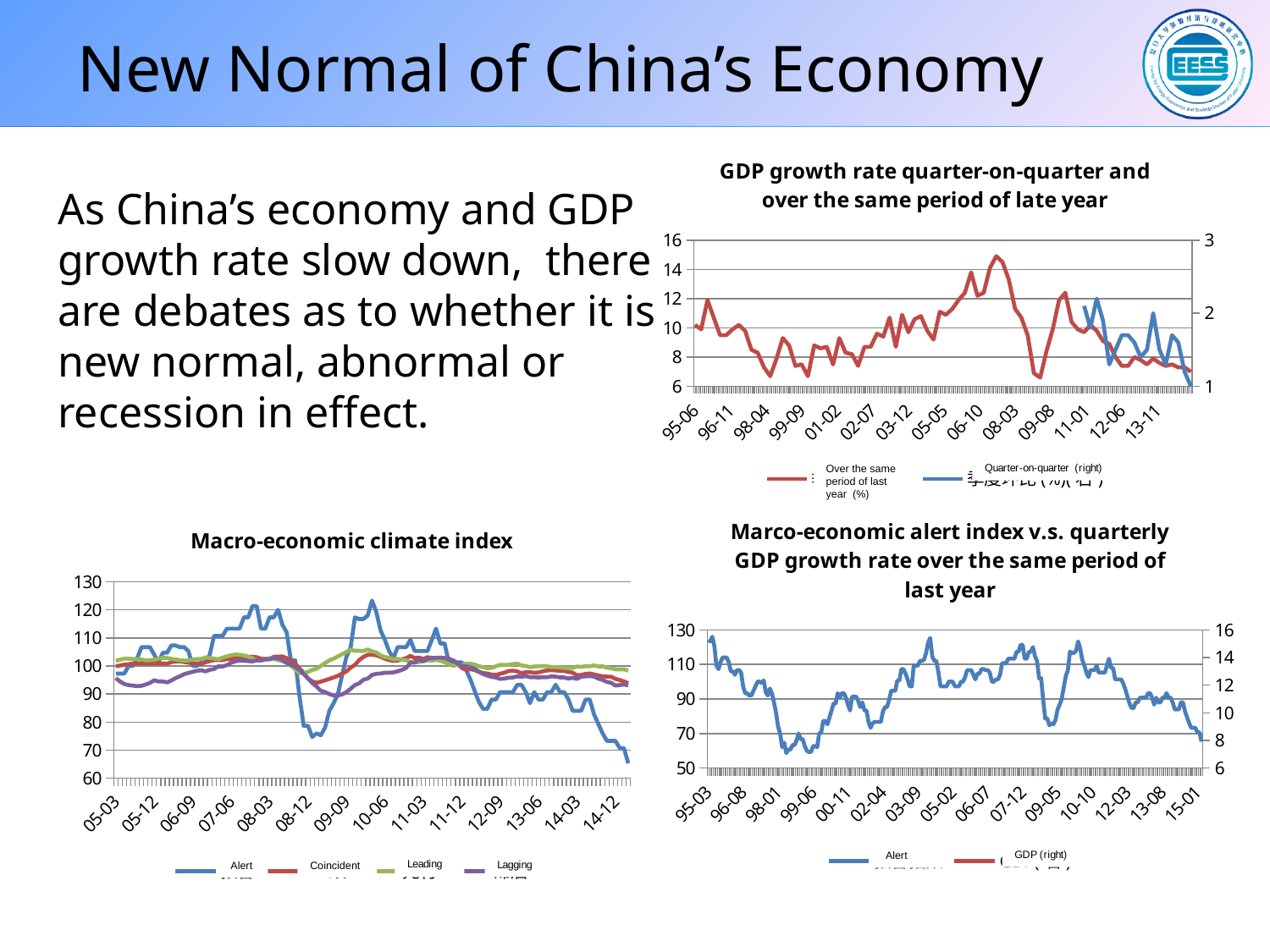
In the "Marco-economic alert index v.s. quarterly GDP growth rate over the same period of last year" chart, which series is plotted on the right axis? GDP What is the highest value shown on the left axis of the "Macro-economic climate index" chart? 130 In the "Macro-economic climate index" chart, is the Alert value at 14-12 greater or less than 70? greater How many series does the legend of the "Marco-economic alert index v.s. quarterly GDP growth rate over the same period of last year" chart list? 2 What kind of chart is the "Macro-economic climate index" chart? line chart In the "Marco-economic alert index v.s. quarterly GDP growth rate over the same period of last year" chart, is the Alert value at 95-03 higher or lower than at 15-01? higher How many series does the legend of the "Macro-economic climate index" chart list? 4 In the "GDP growth rate quarter-on-quarter and over the same period of late year" chart, does the Quarter-on-quarter line generally rise or fall from 11-01 to 13-11? fall In the "Marco-economic alert index v.s. quarterly GDP growth rate over the same period of last year" chart, does the Alert line rise or fall from 13-08 to 15-01? fall In the "GDP growth rate quarter-on-quarter and over the same period of late year" chart, is the lowest value of the "Over the same period of last year" line greater or less than 8? less How many series does the legend of the "GDP growth rate quarter-on-quarter and over the same period of late year" chart list? 2